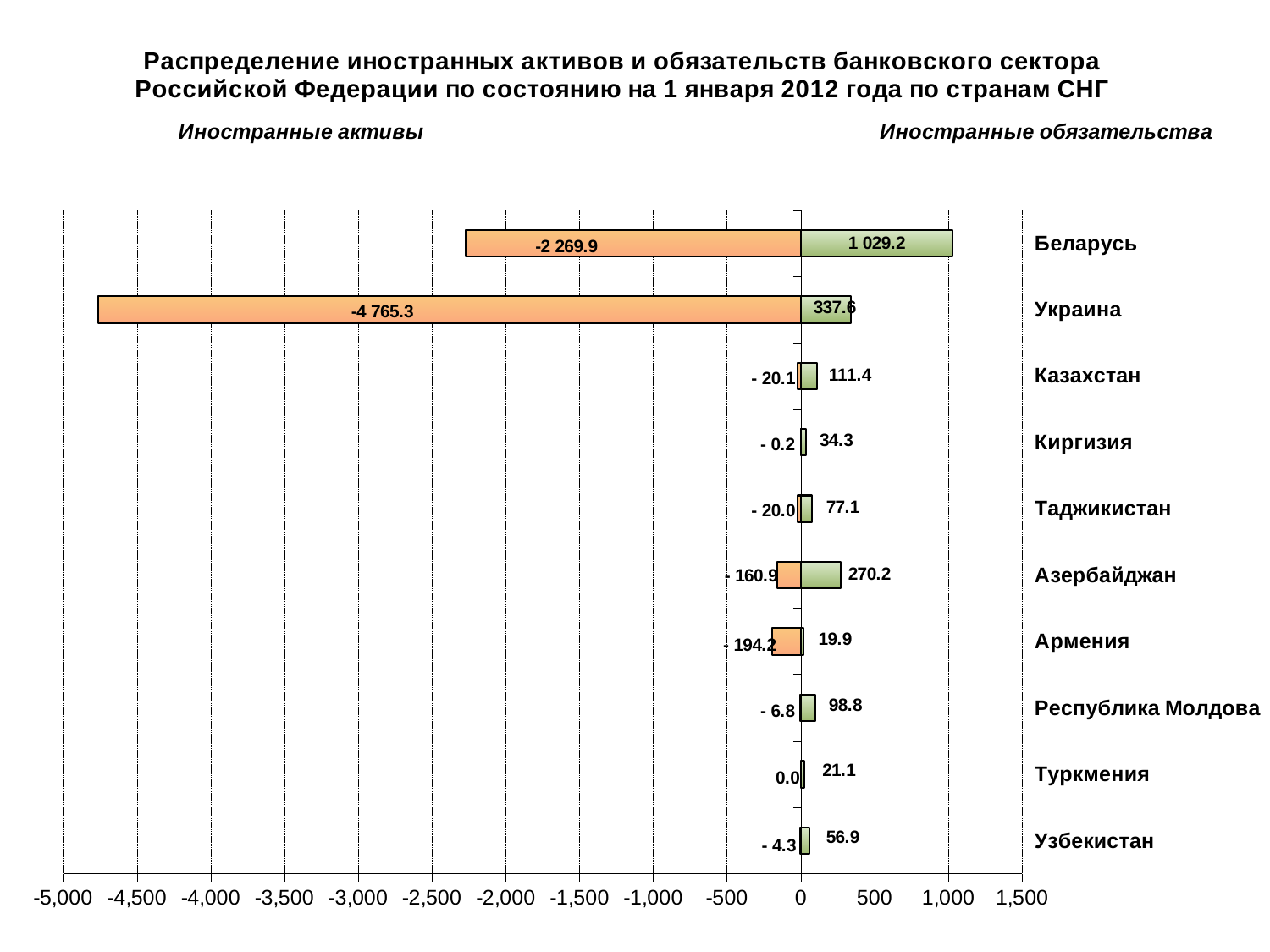
What type of chart is shown on the slide? Bar chart What is the value of foreign assets (Иностранные активы) for Украина? -4 765.3 Is the foreign assets value for Беларусь greater or less than -2,500? greater Which country has the highest foreign liabilities value? Беларусь Which side of the chart shows foreign assets (Иностранные активы), left or right? Left What is the difference between the foreign liabilities of Беларусь and Украина? 691.6 Which country has larger foreign liabilities, Казахстан or Республика Молдова? Казахстан What is the foreign assets value shown for Армения? - 194.2 Which country has the lowest foreign liabilities value? Армения What is the foreign liabilities value shown for Азербайджан? 270.2 How many countries are shown on the chart? 10 What is the value of foreign liabilities (Иностранные обязательства) for Беларусь? 1 029.2